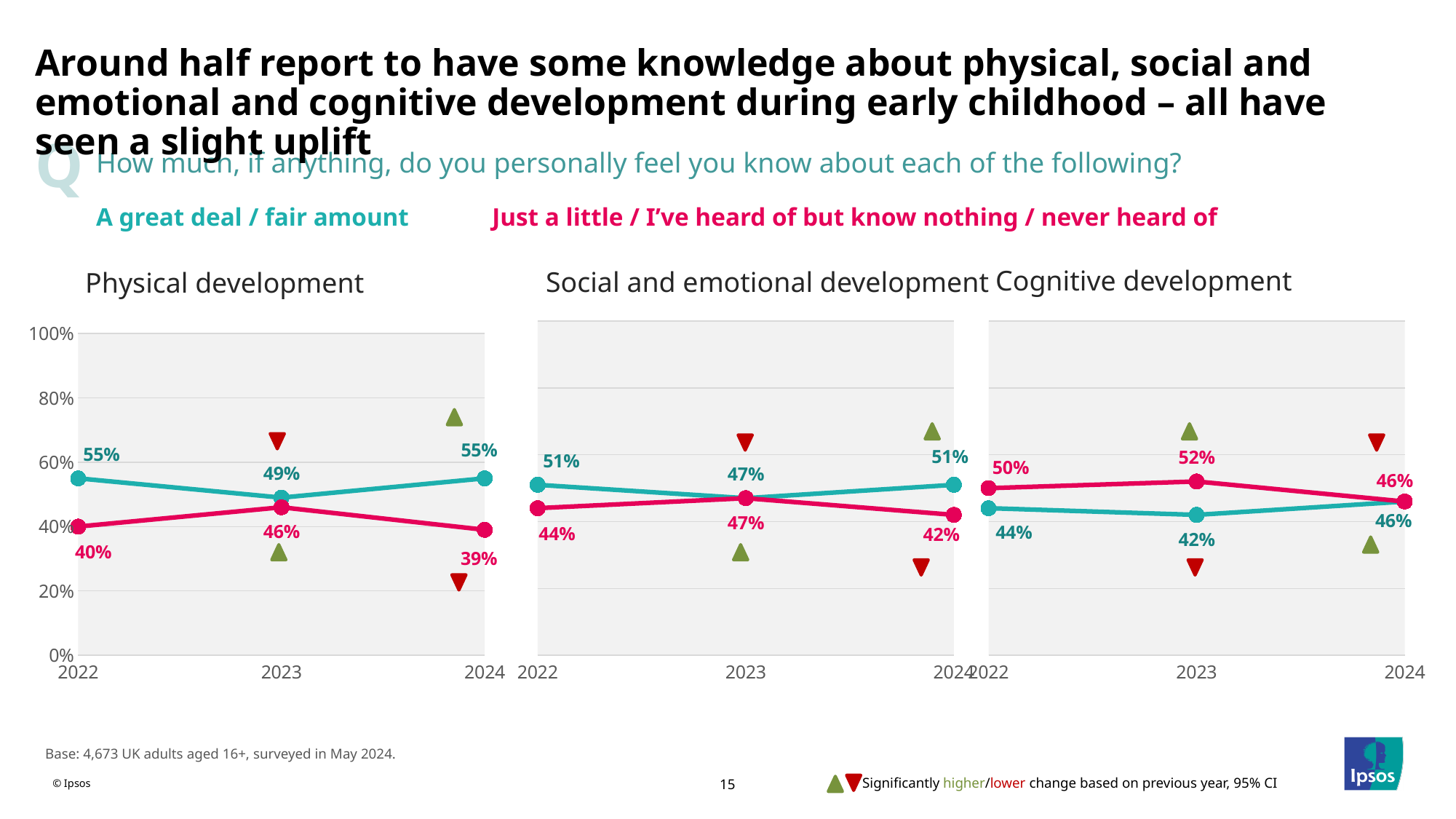
In the Cognitive development chart, what is the value for 'Just a little / I've heard of but know nothing / never heard of' in 2023? 52% In the Cognitive development chart, what is the value for 'A great deal / fair amount' in 2023? 42% What kind of chart is used for Physical development? Line chart In the Social and emotional development chart, what is the value for 'A great deal / fair amount' in 2022? 51% In the Physical development chart, what is the value for 'A great deal / fair amount' in 2024? 55% In the Physical development chart, what is the difference between the 'A great deal / fair amount' value and the 'Just a little / I've heard of but know nothing / never heard of' value in 2024? 16 percentage points In the Social and emotional development chart, which is larger in 2024: 'A great deal / fair amount' or 'Just a little / I've heard of but know nothing / never heard of'? A great deal / fair amount In the Physical development chart, which year has the lowest value for 'A great deal / fair amount'? 2023 How many series are plotted in each chart? 2 How many years are plotted on the x axis of the Cognitive development chart? 3 In the Physical development chart, what is the value for 'Just a little / I've heard of but know nothing / never heard of' in 2023? 46% In the Cognitive development chart, which year has the highest value for 'Just a little / I've heard of but know nothing / never heard of'? 2023